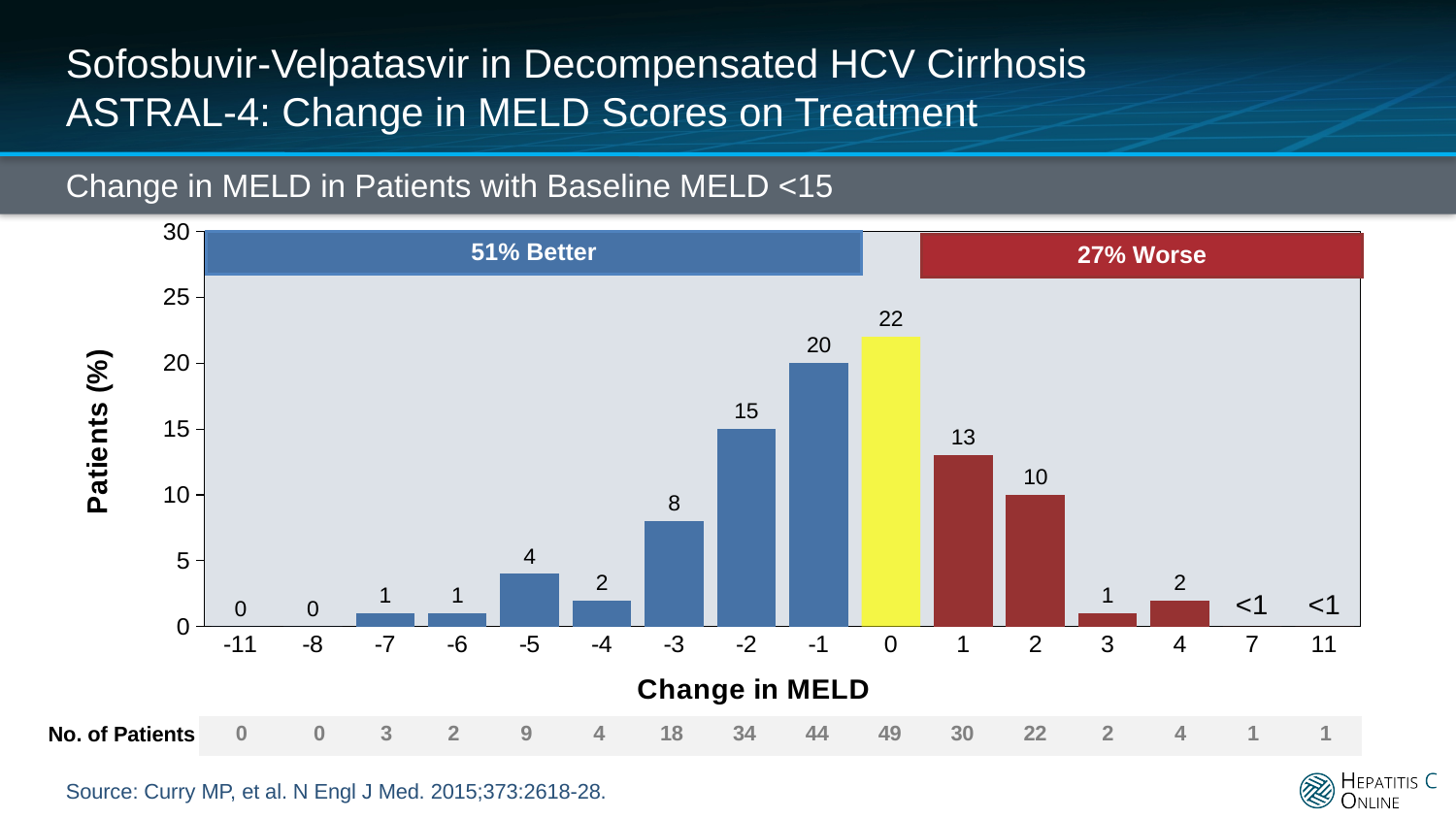
Which has a higher percentage of patients: a MELD change of -1 or a MELD change of +1? -1 Which change in MELD category has the highest percentage of patients? 0 Do the percentages rise or fall as the change in MELD goes from -11 to 0? rise How many change-in-MELD categories are shown on the x axis? 16 Is the percentage of patients with a MELD change of -3 greater or less than 10? less What is the difference in percentage of patients between a MELD change of 0 and a MELD change of -1? 2 What percentage of patients had a change in MELD of 0? 22 What percentage of patients had a change in MELD of +2? 10 According to the annotation on the chart, what percentage of patients had a worse MELD score? 27% Worse What kind of chart is shown on the slide? bar chart What is the difference in percentage of patients between a MELD change of +1 and a MELD change of +2? 3 What percentage of patients had a change in MELD of -2? 15